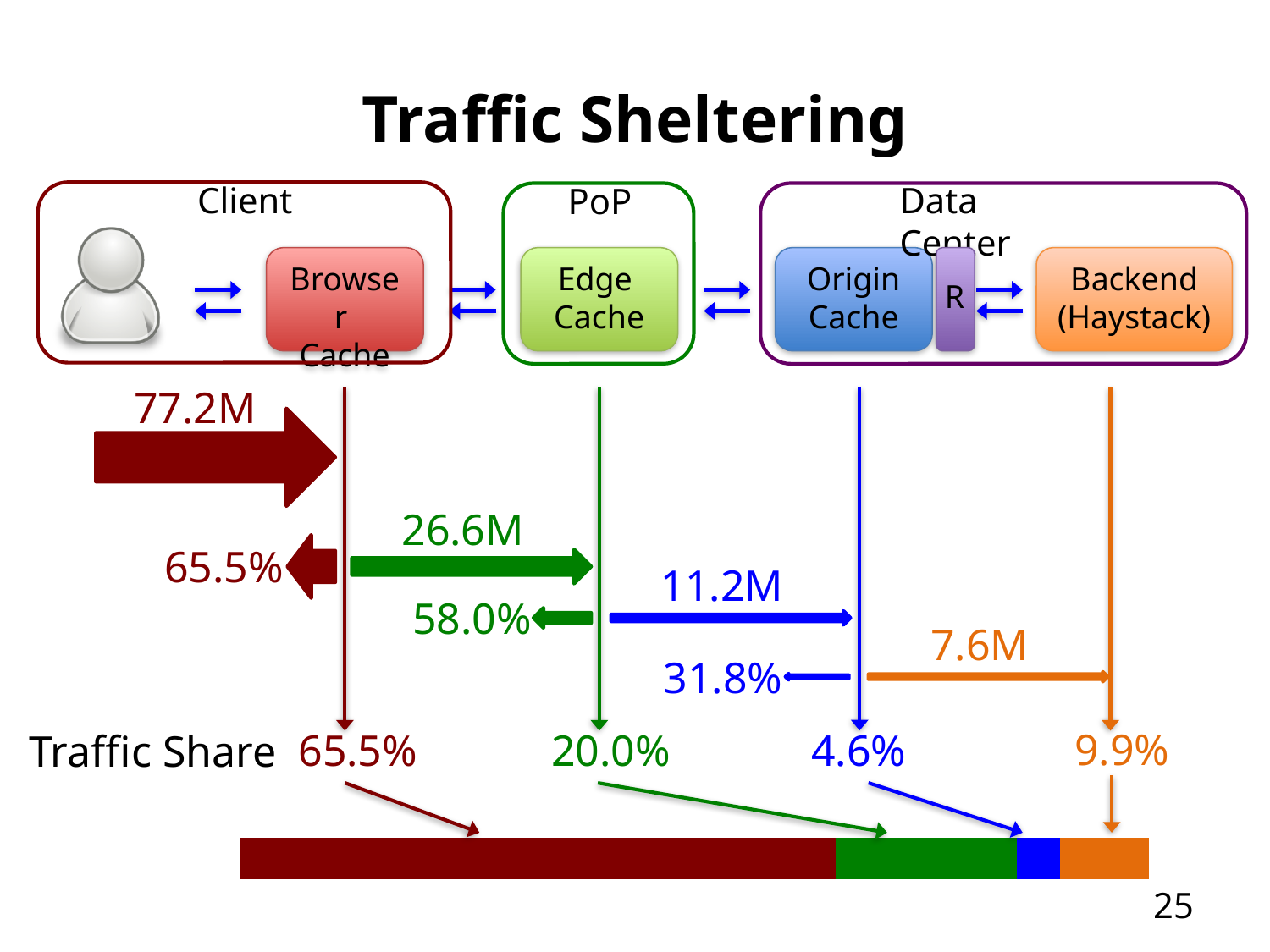
What is the difference between the Browser Cache traffic share and the Edge Cache traffic share? 45.5% Which segment of the traffic share bar is the smallest? Origin Cache (4.6%) Which has a larger traffic share, the Backend (Haystack) segment or the Origin Cache segment? Backend (Haystack) What is the total of the four traffic share segments in the stacked bar? 100% What is the traffic share for the Browser Cache segment in the stacked bar at the bottom of the slide? 65.5% What is the traffic share for the Origin Cache segment in the stacked bar at the bottom of the slide? 4.6% What is the traffic share for the Edge Cache segment in the stacked bar at the bottom of the slide? 20.0% Which segment of the traffic share bar is the largest? Browser Cache (65.5%) What colour is the Edge Cache segment in the traffic share bar? Green How many segments does the traffic share bar at the bottom of the slide have? 4 What is the traffic share for the Backend (Haystack) segment in the stacked bar at the bottom of the slide? 9.9% What colour is the Backend (Haystack) segment in the traffic share bar? Orange